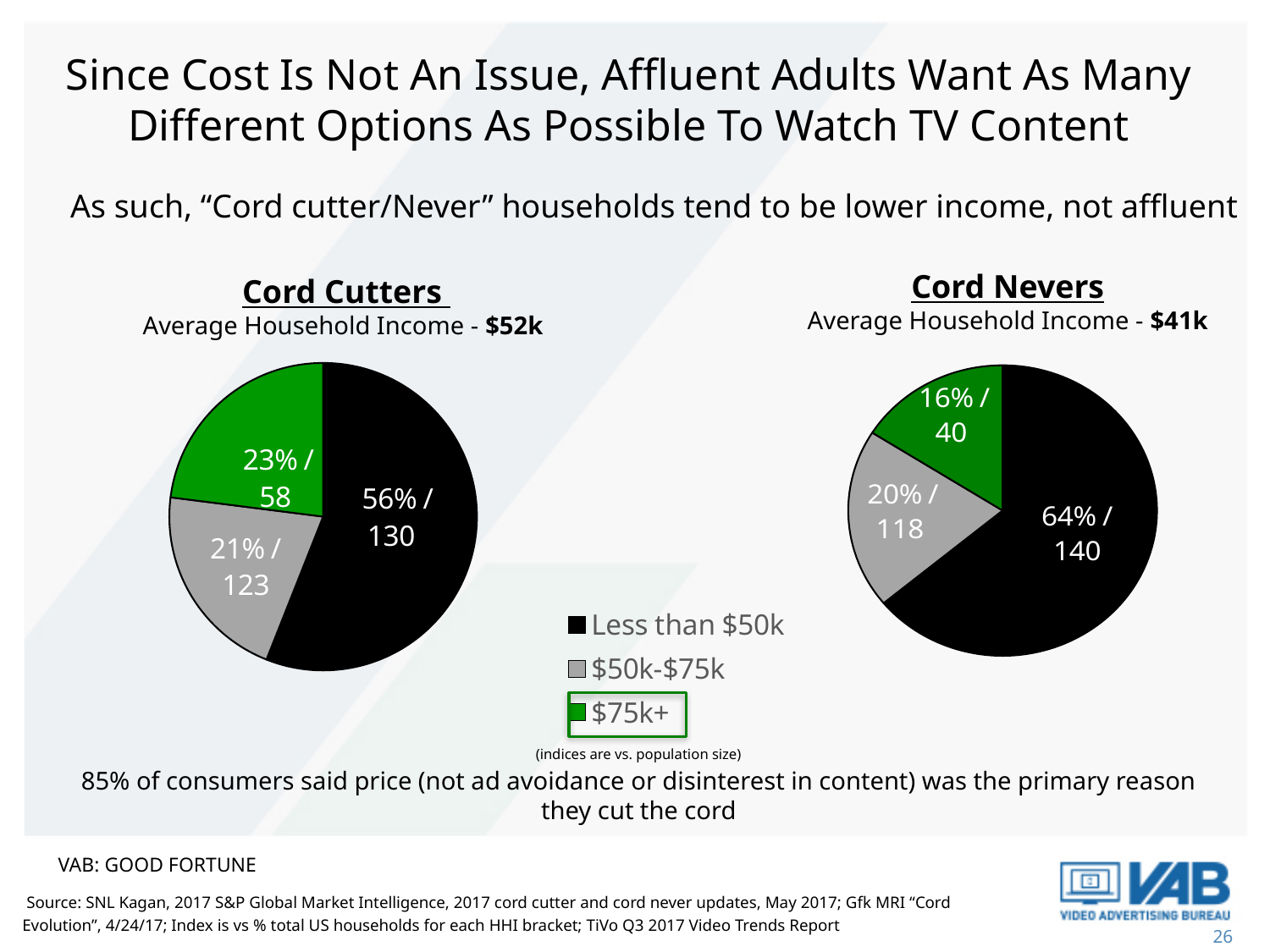
What type of chart is used to show the Cord Nevers household income breakdown? Pie chart In the Cord Cutters pie chart, which income bracket has the smallest share? $50k-$75k Which chart has a larger $75k+ share, Cord Cutters or Cord Nevers? Cord Cutters What is the difference in percentage points between the Less than $50k share in the Cord Nevers chart and the Less than $50k share in the Cord Cutters chart? 8 percentage points In the Cord Cutters pie chart, what share of households have income less than $50k? 56% In the Cord Nevers pie chart, which income bracket has the largest share? Less than $50k How many slices does the Cord Cutters pie chart have? 3 In the Cord Nevers pie chart, what share of households have income of $75k+? 16% What is the average household income shown for Cord Nevers? $41k How many income brackets does the legend list? 3 In the Cord Cutters pie chart, what is the index shown for the $50k-$75k slice? 123 In the Cord Nevers pie chart, what is the index shown for the Less than $50k slice? 140